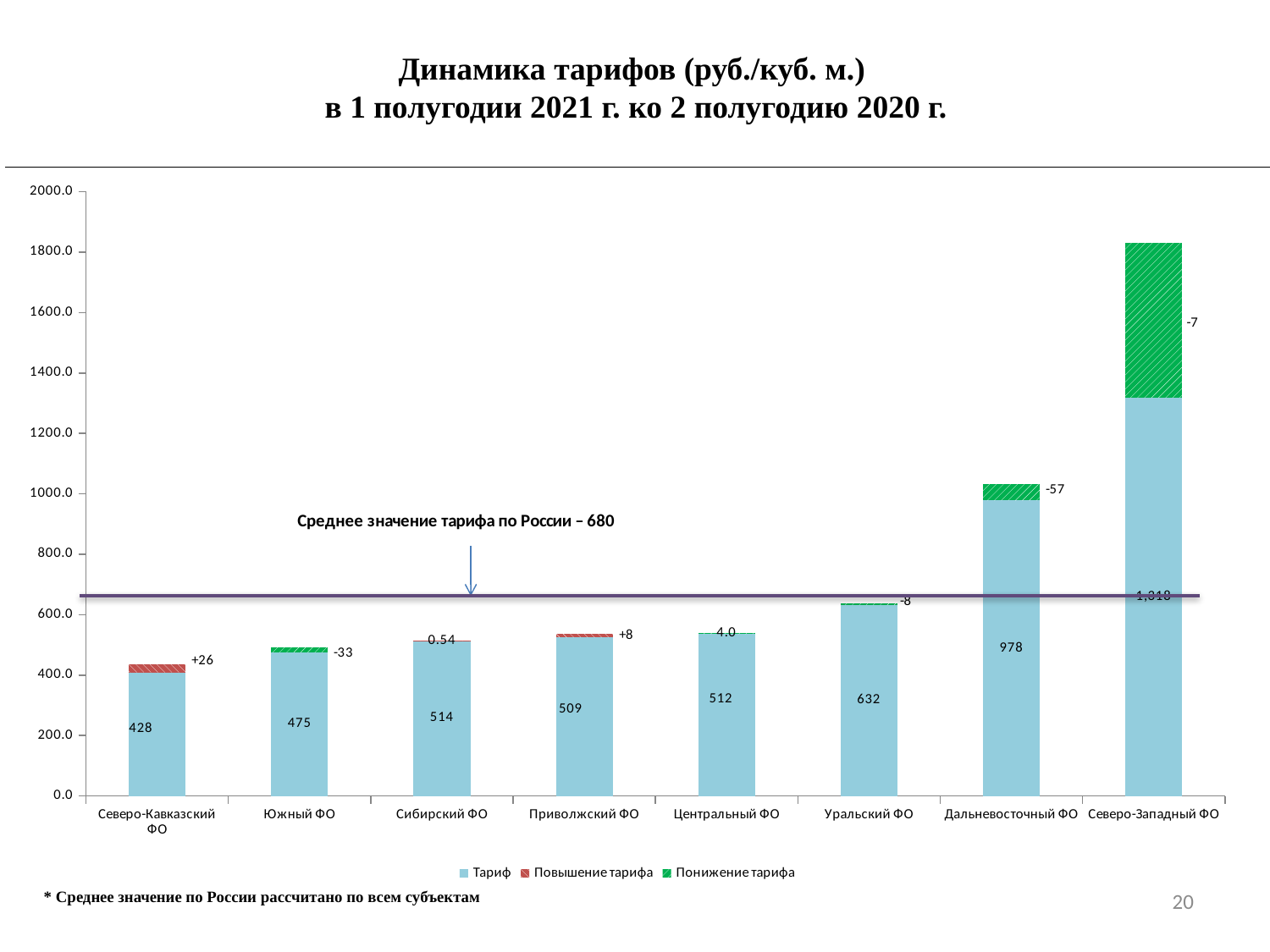
How many series does the legend list? 3 What is the tariff value (Тариф) for Уральский ФО? 632 How many federal districts are shown on the x axis? 8 Is the tariff value for Дальневосточный ФО greater or less than 800? greater Which federal district has the lowest tariff value? Северо-Кавказский ФО What is the difference between the tariff values of Южный ФО and Северо-Кавказский ФО? 47 Which federal district has the highest tariff bar? Северо-Западный ФО What is the average tariff value for Russia indicated by the horizontal line? 680 Which has a larger tariff value, Южный ФО or Сибирский ФО? Сибирский ФО What is the tariff value (Тариф) for Дальневосточный ФО? 978 What is the tariff value (Тариф) for Северо-Кавказский ФО? 428 What is the difference between the tariff values of Дальневосточный ФО and Уральский ФО? 346